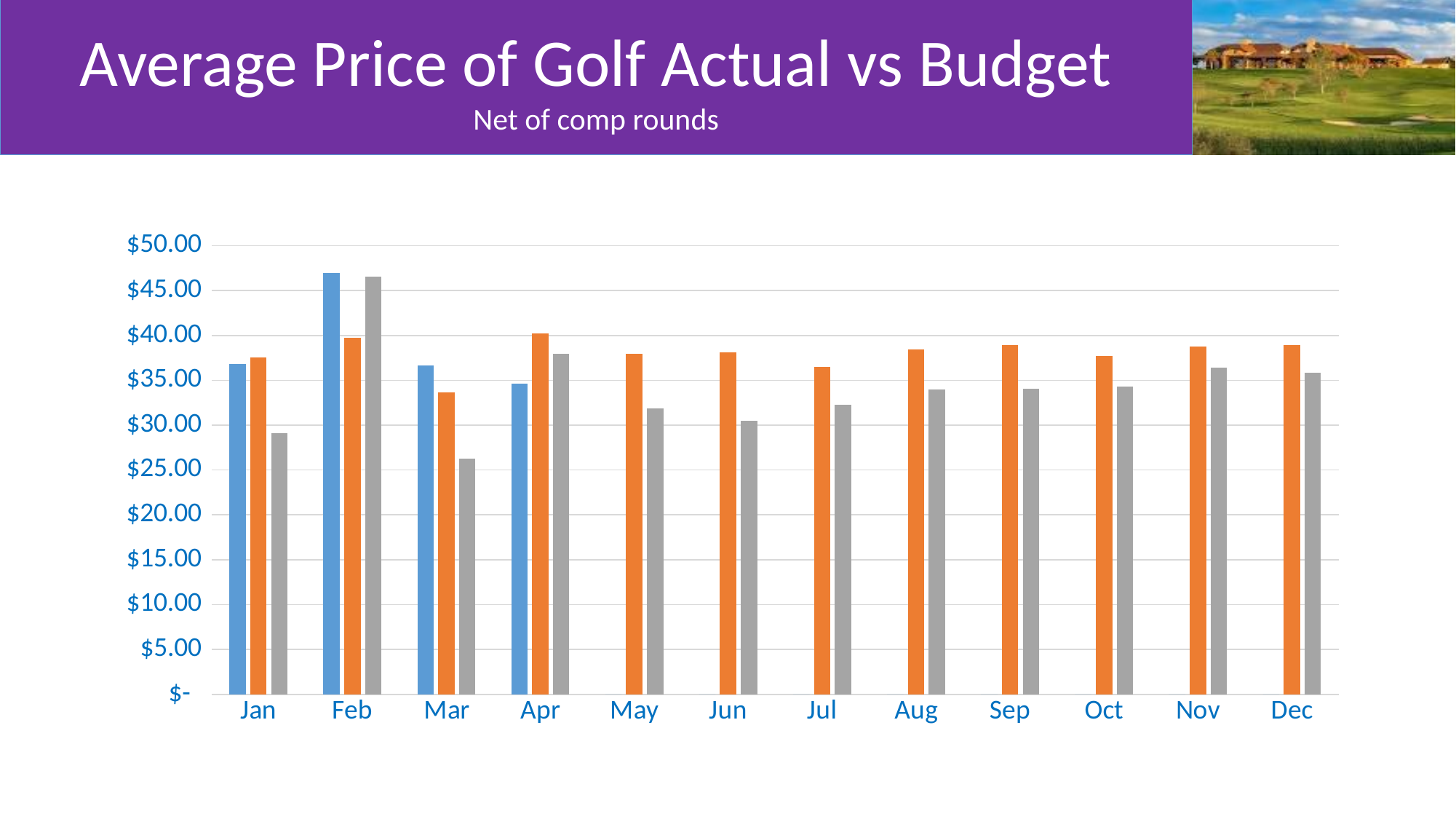
Is the value of the orange bar for Dec greater or less than $35.00? greater For Feb, which is larger: the blue bar or the orange bar? The blue bar For Jan, which is larger: the orange bar or the gray bar? The orange bar What kind of chart is shown on the slide? Bar chart Is the value of the blue bar for Feb greater or less than $45.00? greater In which month is the blue bar the highest? Feb Is the value of the gray bar for Mar greater or less than $30.00? less In which month is the gray bar the lowest? Mar In which month is the gray bar the highest? Feb In which month is the orange bar the lowest? Mar How many months have a blue bar? 4 How many months are shown along the x axis of the chart? 12